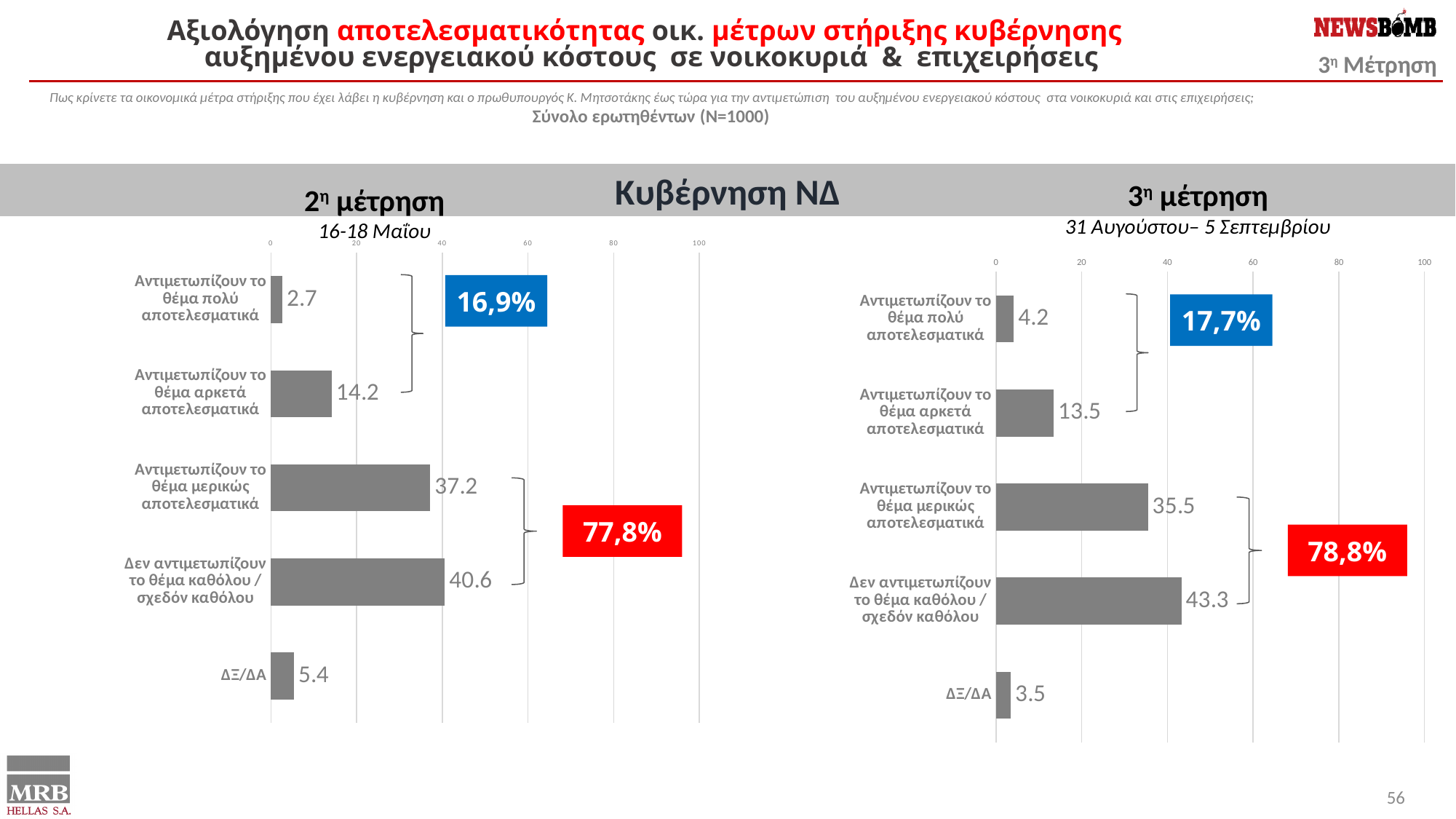
In the right chart (3η μέτρηση, 31 Αυγούστου – 5 Σεπτεμβρίου), what is the value for "Δεν αντιμετωπίζουν το θέμα καθόλου / σχεδόν καθόλου"? 43.3 In the left chart (2η μέτρηση), what is the difference between "Δεν αντιμετωπίζουν το θέμα καθόλου / σχεδόν καθόλου" (40.6) and "Αντιμετωπίζουν το θέμα μερικώς αποτελεσματικά" (37.2)? 3.4 In the left chart (2η μέτρηση), which category has the highest value? Δεν αντιμετωπίζουν το θέμα καθόλου / σχεδόν καθόλου In the right chart (3η μέτρηση), which category has the lowest value? ΔΞ/ΔΑ In the left chart (2η μέτρηση), what combined percentage is shown in the blue box for the two positive categories? 16,9% In the right chart (3η μέτρηση), is the value for "Αντιμετωπίζουν το θέμα μερικώς αποτελεσματικά" greater or less than 40? less In the left chart (2η μέτρηση, 16-18 Μαΐου), what is the value for "Αντιμετωπίζουν το θέμα πολύ αποτελεσματικά"? 2.7 What kind of chart is the right chart (3η μέτρηση)? Bar chart In the right chart (3η μέτρηση), what is the value for "ΔΞ/ΔΑ"? 3.5 In the right chart (3η μέτρηση), what combined percentage is shown in the red box for the two negative categories? 78,8% How many categories are shown in the left chart (2η μέτρηση)? 5 Which is larger: the value for "Αντιμετωπίζουν το θέμα αρκετά αποτελεσματικά" in the left chart (2η μέτρηση) or in the right chart (3η μέτρηση)? Left chart (2η μέτρηση), 14.2